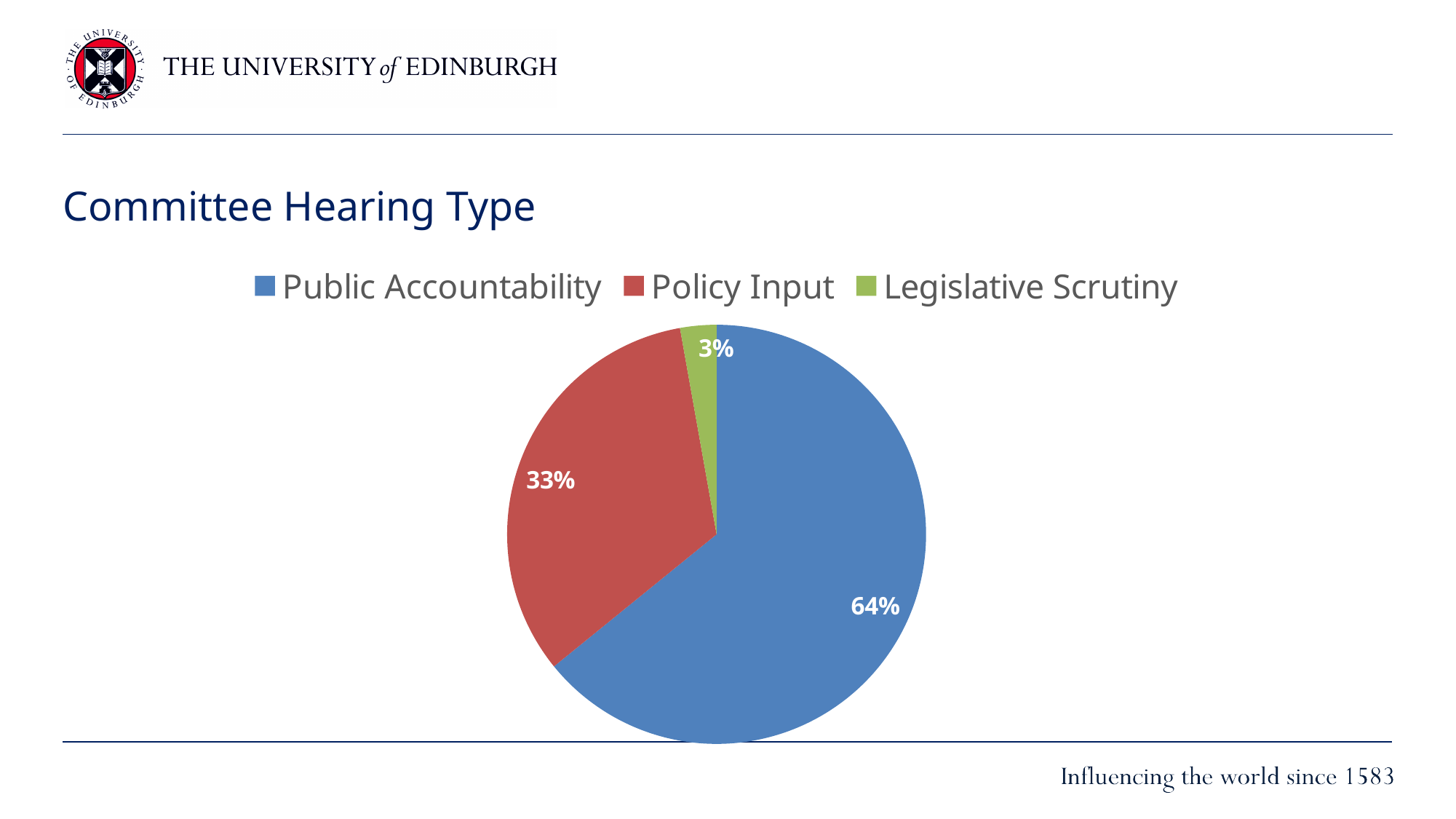
What share of the pie does Policy Input represent? 33% What kind of chart is shown on the slide? Pie chart What share of the pie does Legislative Scrutiny represent? 3% How many categories are shown in the pie chart? 3 Which colour represents Policy Input in the chart? Red Which committee hearing type has the smallest share? Legislative Scrutiny Which is larger, Policy Input or Legislative Scrutiny? Policy Input Which committee hearing type has the largest share? Public Accountability What is the title of the chart? Committee Hearing Type What is the difference in percentage points between Policy Input and Legislative Scrutiny? 30 What share of the pie does Public Accountability represent? 64% What is the difference in percentage points between Public Accountability and Policy Input? 31